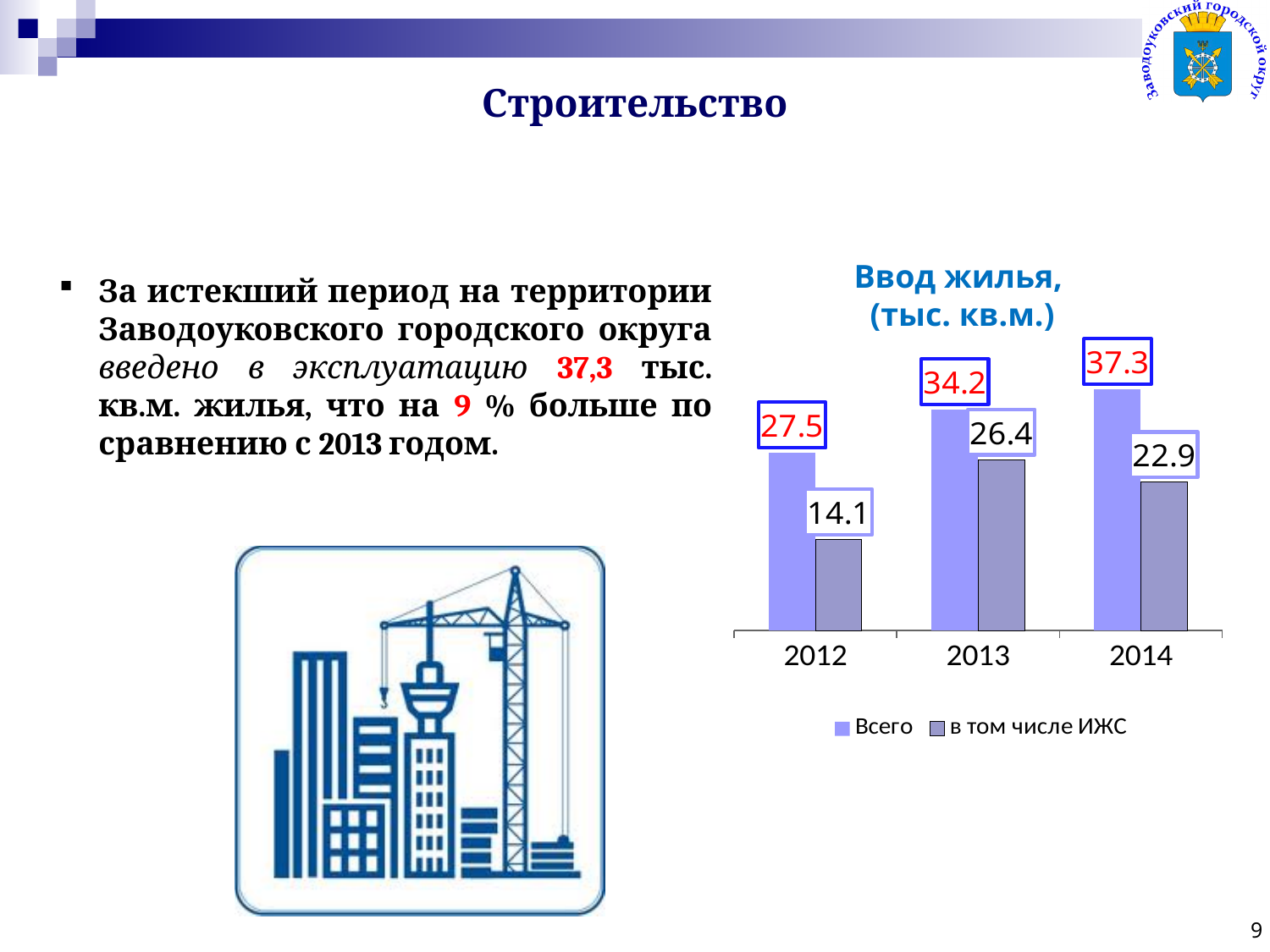
What is the difference between the 'Всего' values for 2014 and 2013 in the 'Ввод жилья' chart? 3.1 In which year is the 'Всего' value highest in the 'Ввод жилья' chart? 2014 What is the difference between the 'Всего' and 'в том числе ИЖС' values for 2012 in the 'Ввод жилья' chart? 13.4 What is the value of the 'в том числе ИЖС' series for 2013 in the 'Ввод жилья' chart? 26.4 What is the value of the 'Всего' series for 2014 in the 'Ввод жилья, (тыс. кв.м.)' chart? 37.3 How many years are shown on the x axis of the 'Ввод жилья' chart? 3 How many series does the legend of the 'Ввод жилья' chart list? 2 Does the 'Всего' series rise or fall from 2012 to 2014 in the 'Ввод жилья' chart? rise What is the value of the 'в том числе ИЖС' series for 2012 in the 'Ввод жилья' chart? 14.1 What kind of chart is the 'Ввод жилья, (тыс. кв.м.)' chart? bar chart In which year is the 'в том числе ИЖС' value lowest in the 'Ввод жилья' chart? 2012 Which is larger in the 'Ввод жилья' chart: the 'в том числе ИЖС' value for 2013 or for 2014? 2013